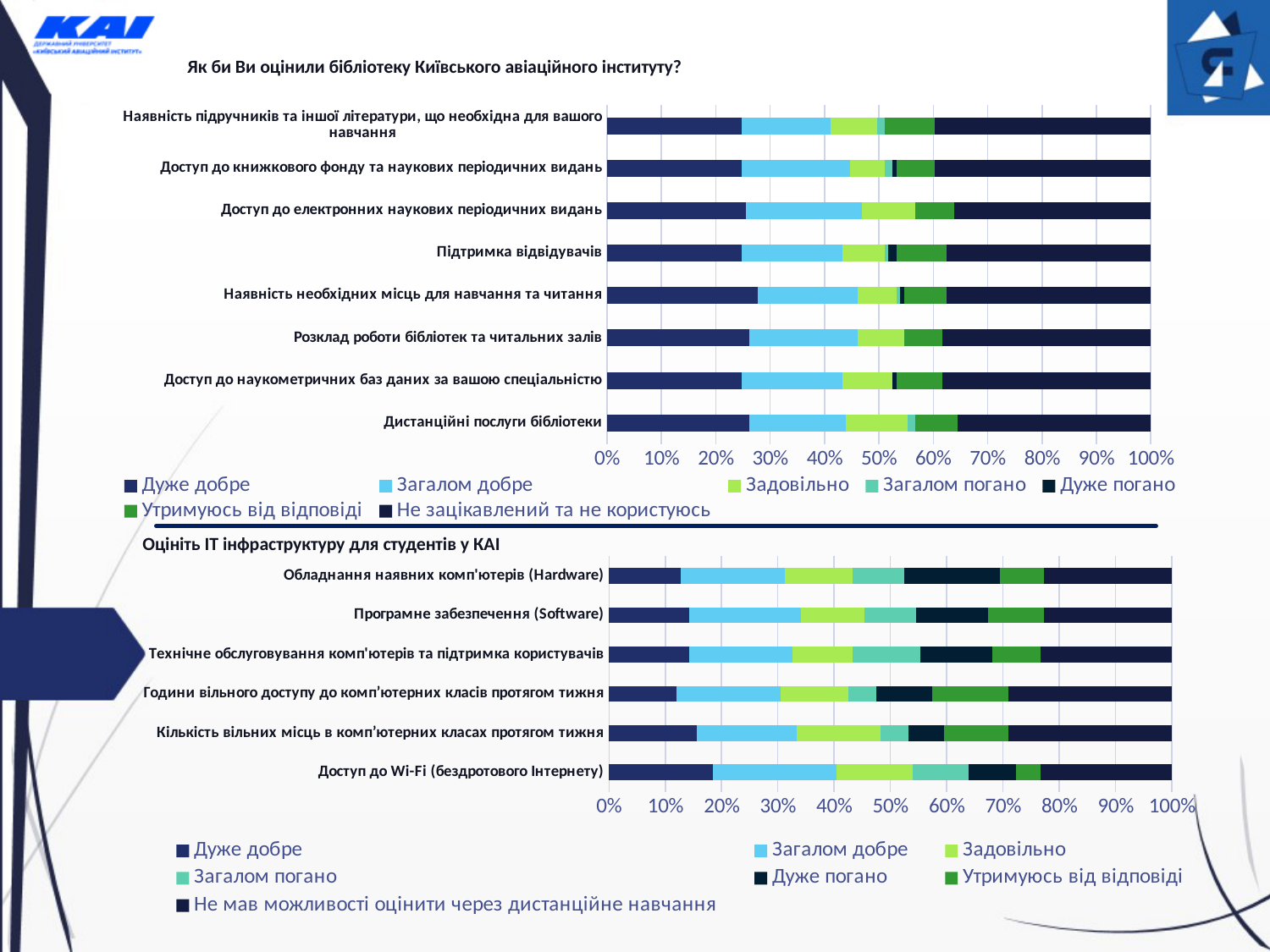
In the bottom chart (IT infrastructure), which has the larger "Дуже добре" segment: "Доступ до Wi-Fi (бездротового Інтернету)" or "Обладнання наявних комп'ютерів (Hardware)"? Доступ до Wi-Fi (бездротового Інтернету) What kind of chart is the top chart titled "Як би Ви оцінили бібліотеку Київського авіаційного інституту?"? Stacked bar chart In the bottom chart (IT infrastructure), is the "Дуже добре" share for "Обладнання наявних комп'ютерів (Hardware)" greater or less than 20%? less How many series does the legend of the top chart (library evaluation) list? 7 How many categories are plotted in the top chart about the library of the Kyiv Aviation Institute? 8 How many categories are plotted in the bottom chart titled "Оцініть ІТ інфраструктуру для студентів у КАІ"? 6 What is the maximum value shown on the x axis of the top chart (library evaluation)? 100% In the top chart (library evaluation), is the "Дуже добре" share for "Наявність необхідних місць для навчання та читання" greater or less than 20%? greater In the bottom chart (IT infrastructure), is the "Дуже добре" share for "Доступ до Wi-Fi (бездротового Інтернету)" greater or less than 10%? greater How many series does the legend of the bottom chart (IT infrastructure) list? 7 What is the title of the bottom chart on the slide? Оцініть ІТ інфраструктуру для студентів у КАІ In the bottom chart (IT infrastructure), which category has the largest "Дуже добре" segment? Доступ до Wi-Fi (бездротового Інтернету)